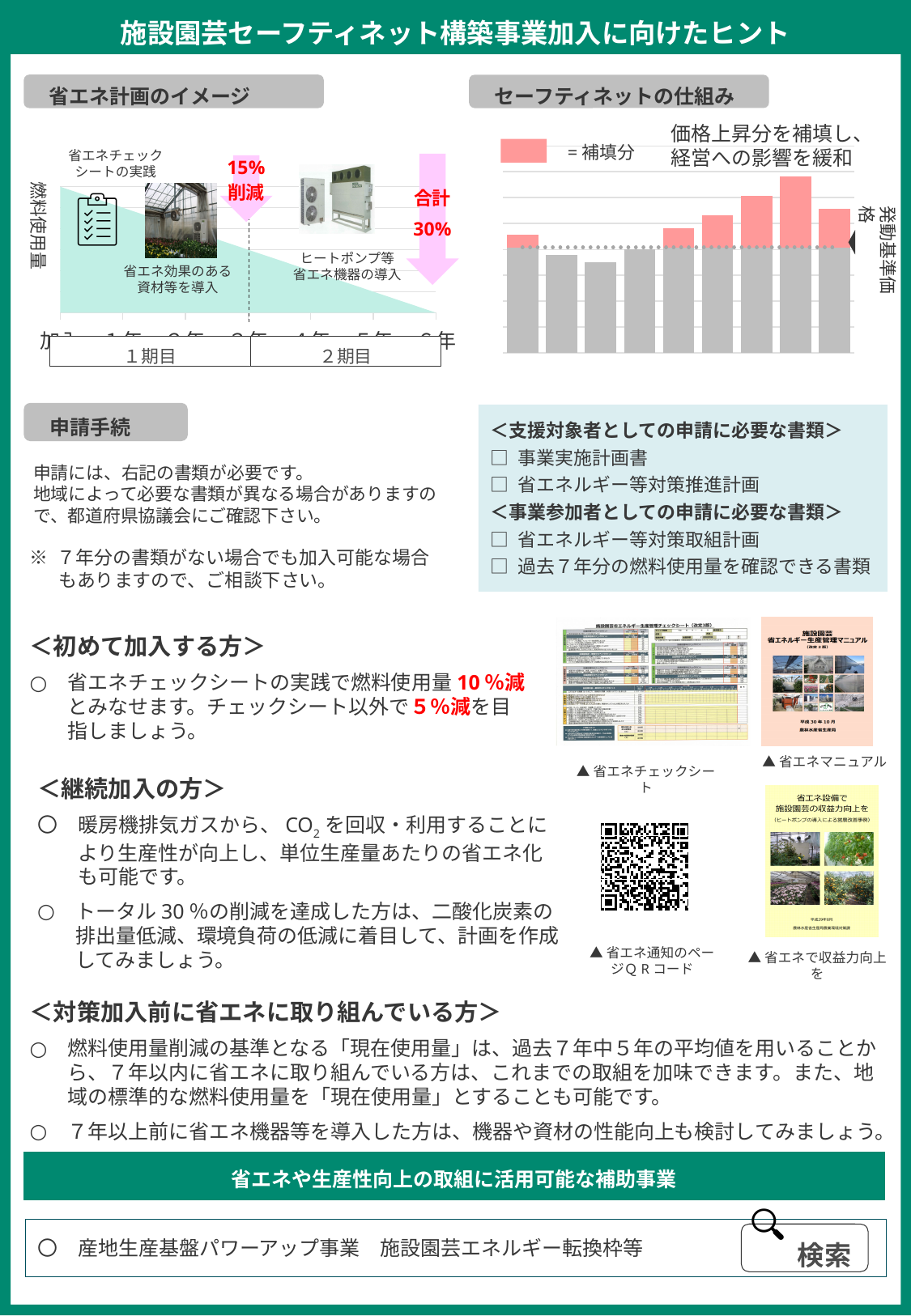
What kind of chart is shown under 「セーフティネットの仕組み」 on the right of the slide? bar chart In the 「セーフティネットの仕組み」 chart, how many bars have a pink 補填分 portion on top? 6 In the 「省エネ計画のイメージ」 chart on the left, does the fuel usage (燃料使用量) rise or fall over the years along the x axis? fall In the 「省エネ計画のイメージ」 chart, what reduction is labelled at the end of 1期目 (around 3年)? 15%削減 In the 「省エネ計画のイメージ」 chart, how many periods (期) are marked below the x axis? 2 In the 「セーフティネットの仕組み」 chart, what does the pink colour represent according to the legend? 補填分 How many bars are plotted in the 「セーフティネットの仕組み」 chart? 9 In the 「省エネ計画のイメージ」 chart, what total reduction is labelled at the end of 2期目 (6年)? 合計30% In the 「セーフティネットの仕組み」 chart, which bar is the shortest? the 3rd bar from the left In the 「セーフティネットの仕組み」 chart, is the 8th bar from the left taller or shorter than the 2nd bar from the left? taller What is the label on the vertical axis of the 「省エネ計画のイメージ」 chart? 燃料使用量 In the 「セーフティネットの仕組み」 chart, which bar is the tallest? the 8th bar from the left